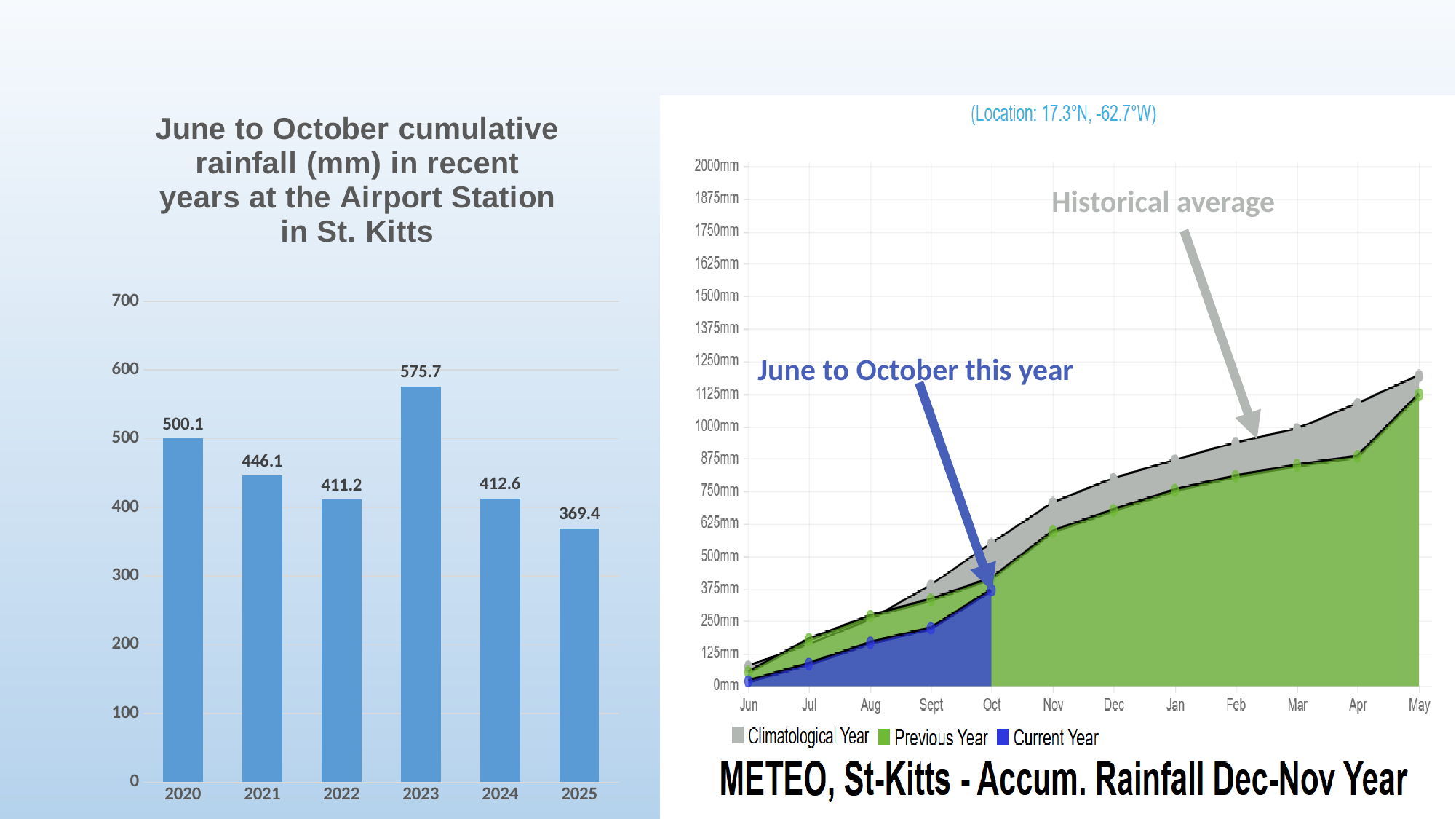
In the left chart, what was the June to October cumulative rainfall in 2023? 575.7 In the left chart, which year had the highest June to October cumulative rainfall? 2023 In the right chart (METEO, St-Kitts), is the Climatological Year value at May greater or less than 1125mm? greater In the left chart, what was the June to October cumulative rainfall in 2025? 369.4 How many series does the legend of the right chart (METEO, St-Kitts) list? 3 How many years are shown in the left bar chart? 6 In the left chart, which year had more rainfall, 2020 or 2021? 2020 In the left chart, which year had the lowest June to October cumulative rainfall? 2025 What type of chart is the left chart? bar chart In the left chart, what is the difference between the 2023 and 2025 values? 206.3 In the right chart (METEO, St-Kitts), is the Climatological Year value at Nov greater or less than 625mm? greater In the right chart (METEO, St-Kitts), which colour represents the Current Year series? blue